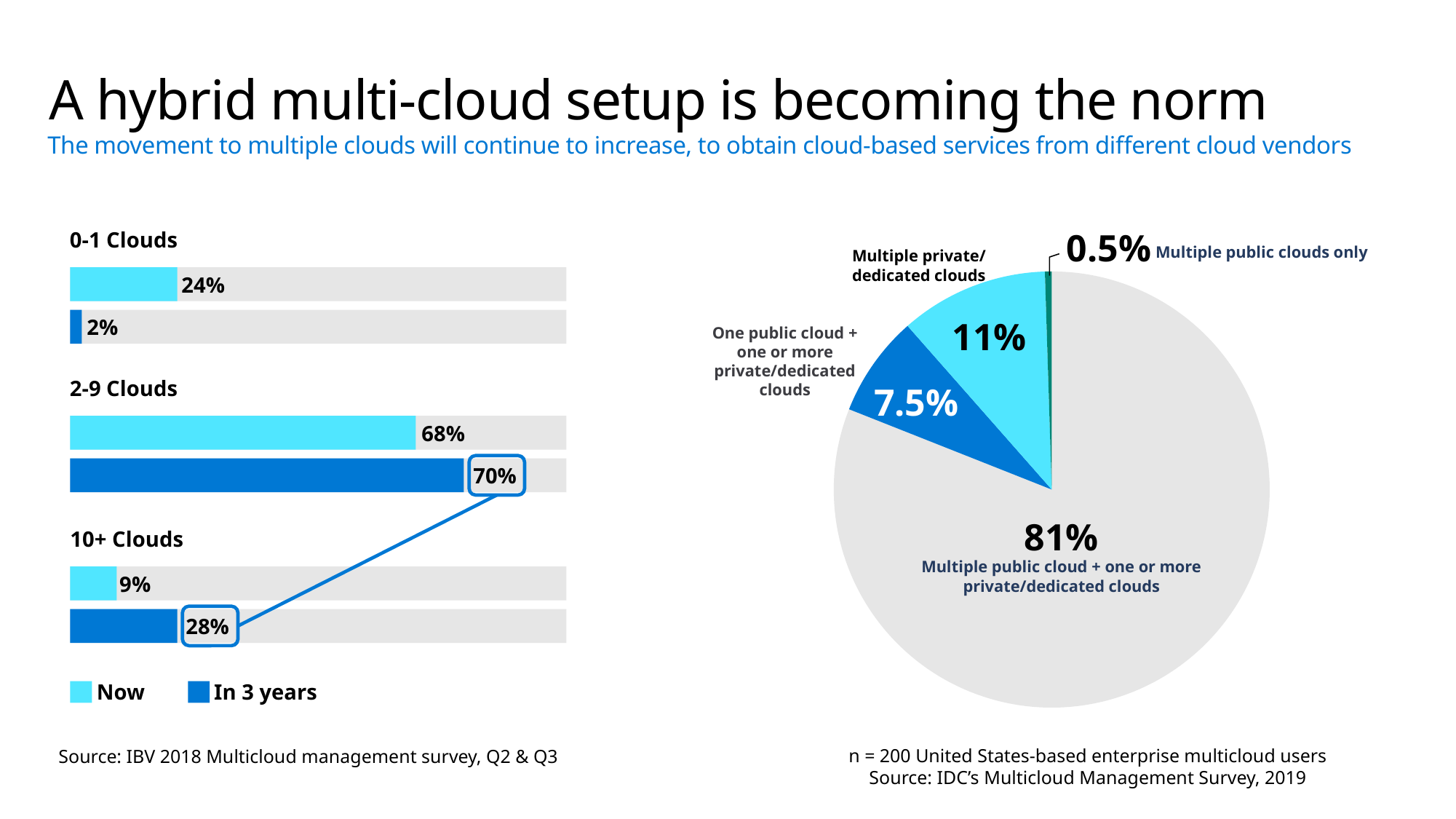
How many slices does the pie chart on the right have? 4 In the bar chart on the left, which category has the highest 'In 3 years' value? 2-9 Clouds How many series does the legend of the bar chart on the left list? 2 In the pie chart on the right, what share is 'One public cloud + one or more private/dedicated clouds'? 7.5% In the bar chart on the left, which category has the lowest 'Now' value? 10+ Clouds In the bar chart on the left, what is the 'In 3 years' value for 10+ Clouds? 28% In the bar chart on the left, which is larger for 10+ Clouds: the 'Now' value or the 'In 3 years' value? In 3 years In the pie chart on the right, which slice is the smallest? Multiple public clouds only In the bar chart on the left, what is the difference between the 'Now' and 'In 3 years' values for 0-1 Clouds? 22% What kind of chart is shown on the left of the slide? Bar chart In the bar chart on the left, what is the 'In 3 years' value for 0-1 Clouds? 2% In the bar chart on the left, what is the 'Now' value for 2-9 Clouds? 68%